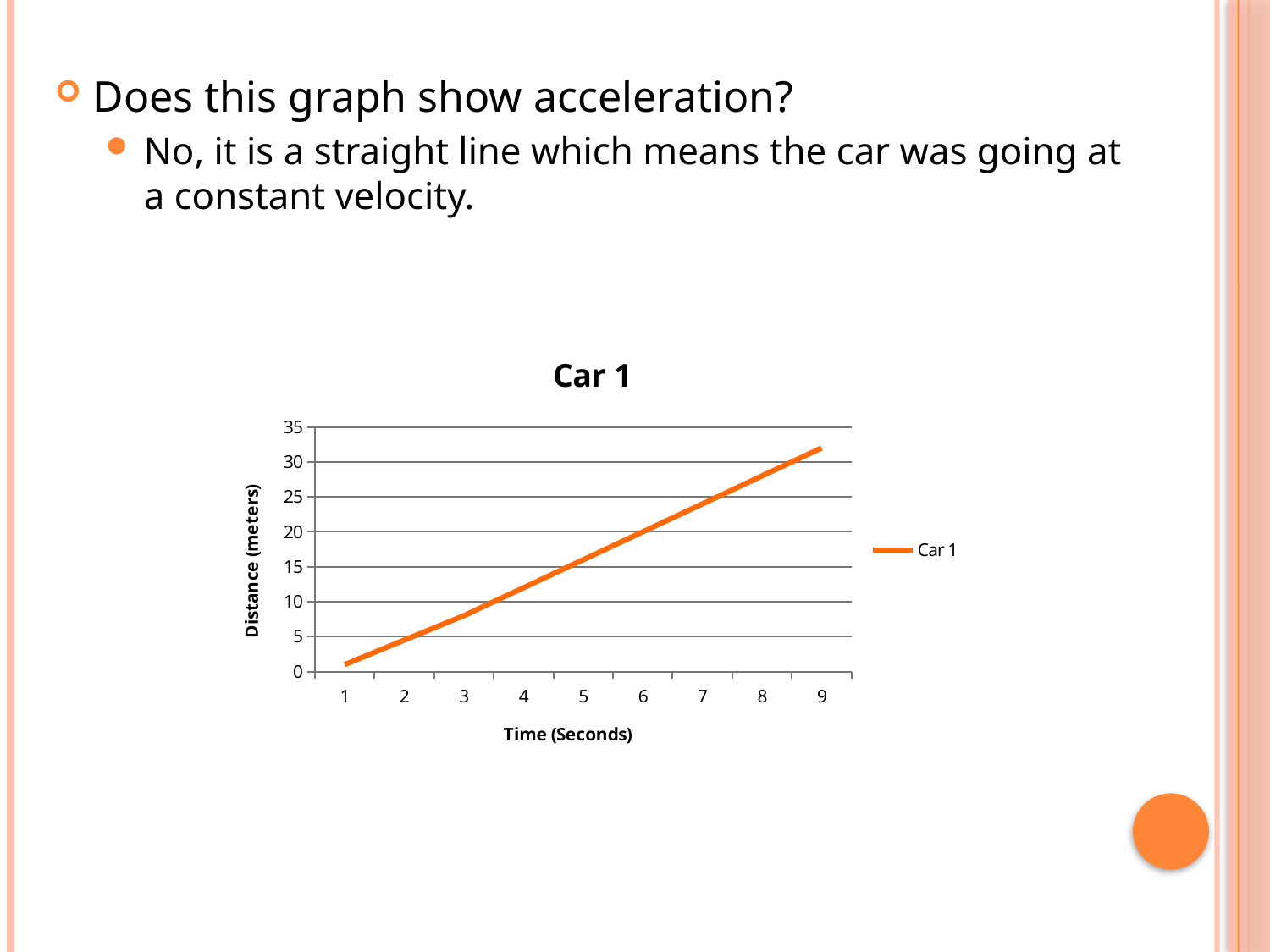
What is the title of the chart? Car 1 Is the distance at 3 seconds greater or less than 10? less What is the label of the y axis? Distance (meters) At which time (in seconds) is the distance highest? 9 Is the distance at 1 second greater or less than 5? less Does the distance rise or fall as time increases along the x axis? rise How many series does the legend list? 1 What kind of chart is shown on the slide? line chart Is the distance at 8 seconds greater or less than 25? greater How many time points are plotted along the x axis? 9 At which time (in seconds) is the distance lowest? 1